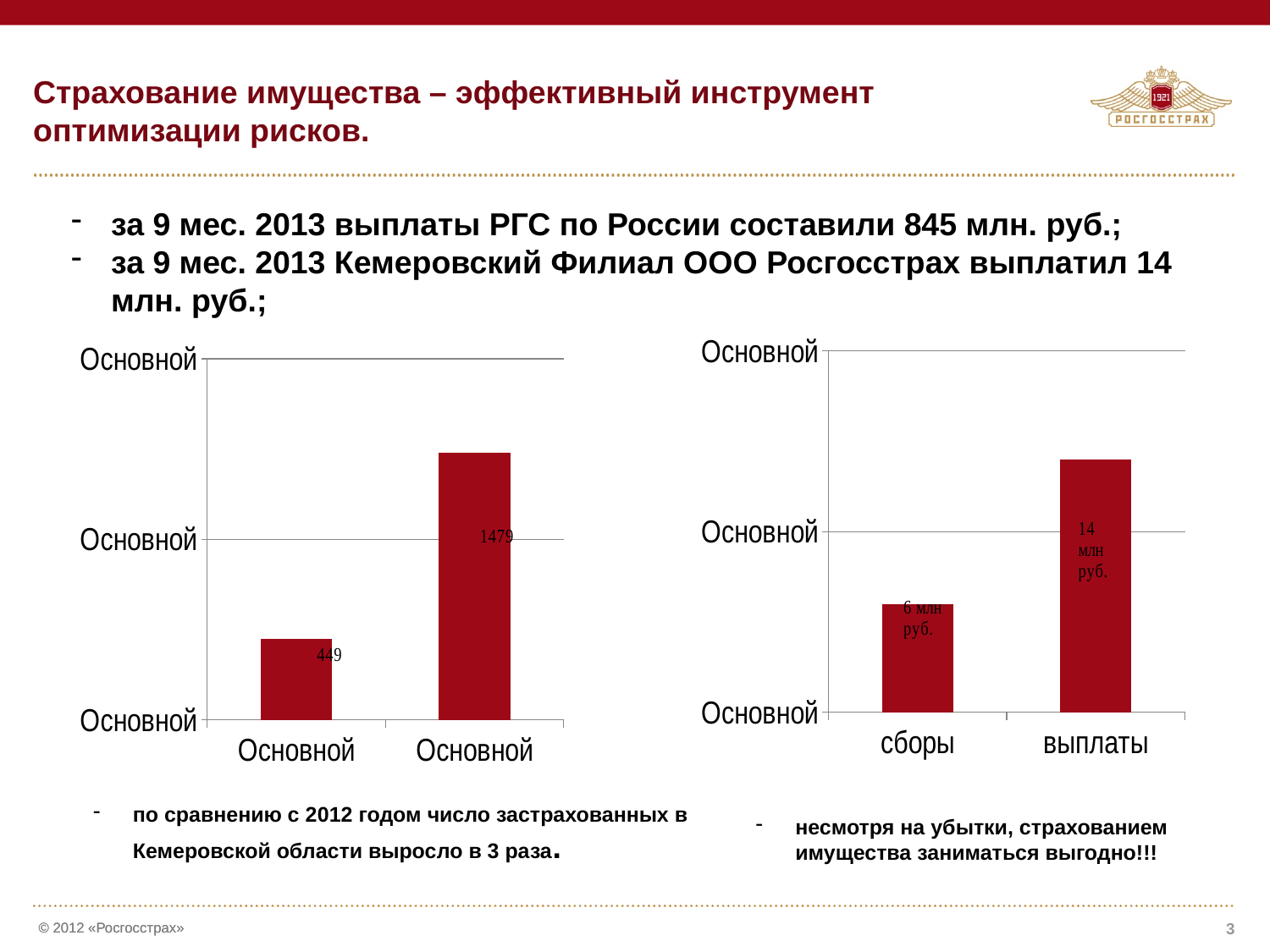
On the right chart, how many bars are plotted? 2 On the left chart, what is the data label on the left bar? 449 On the right chart, what is the value for сборы? 6 млн руб. On the right chart, which category has the higher value, сборы or выплаты? выплаты What colour are the bars on both charts? dark red On the left chart, do the values rise or fall from the left bar to the right bar? rise On the right chart, what is the difference between выплаты and сборы? 8 млн руб. On the left chart, what is the data label on the right bar? 1479 On the right chart, which category has the lowest value? сборы On the right chart, what is the value for выплаты? 14 млн руб. What kind of chart is the right chart? bar chart On the left chart, what is the difference between the right bar (1479) and the left bar (449)? 1030